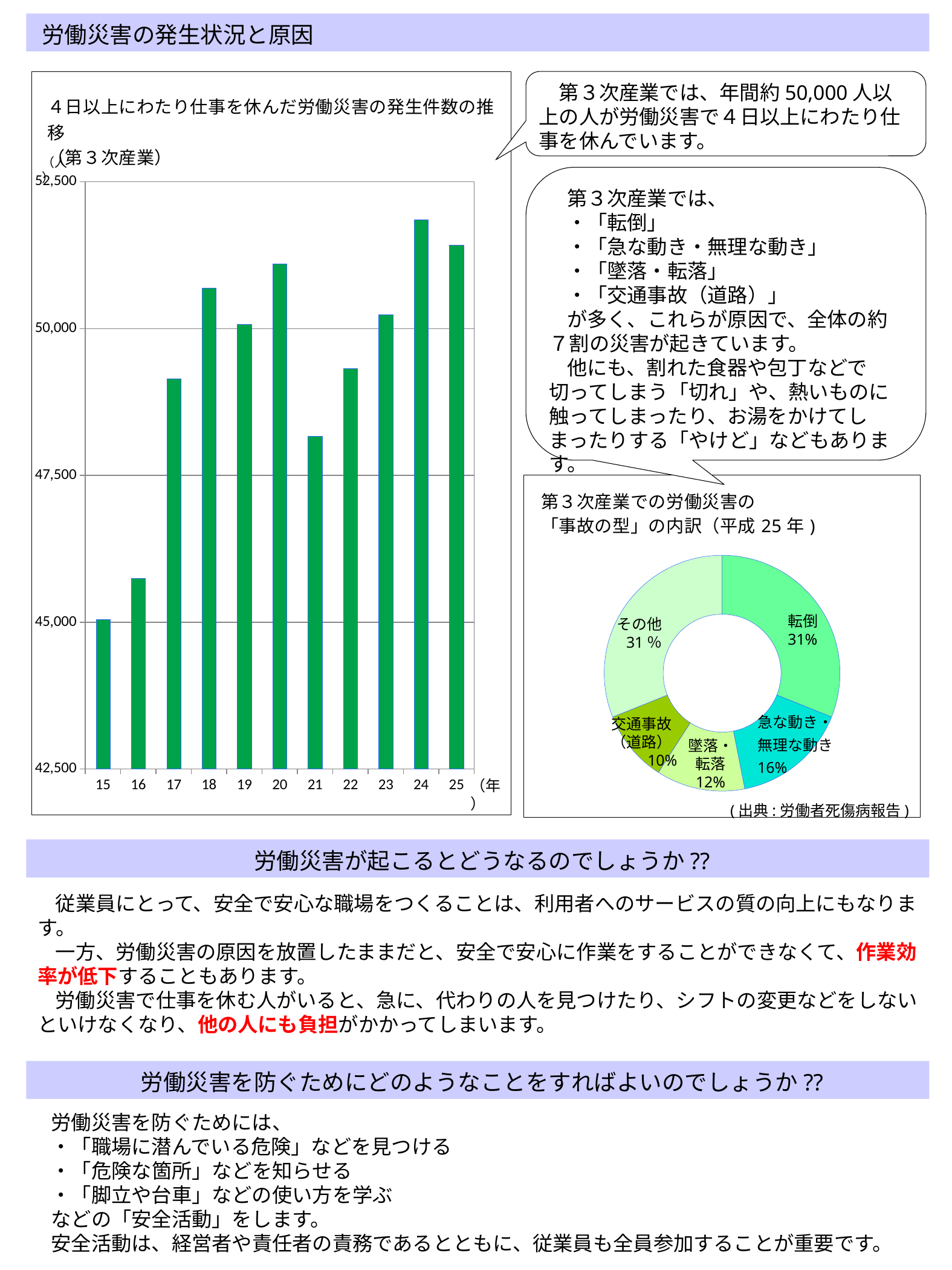
In the bar chart on the left, which year has the highest value? 24 In the bar chart on the left, how many years are plotted? 11 In the bar chart on the left, is the value for year 24 greater or less than 50,000? greater In the doughnut chart on the right, which category has the smallest share? 交通事故（道路） In the bar chart on the left, is the value for year 21 greater or less than 47,500? greater In the bar chart on the left, which year has the lowest value? 15 In the doughnut chart on the right, what share is 転倒? 31% In the doughnut chart on the right, what is the difference between the shares of 転倒 and 急な動き・無理な動き? 15 percentage points What kind of chart is the chart on the left? bar chart In the bar chart on the left, is the value for year 17 greater or less than 50,000? less In the bar chart on the left, do the values rise or fall from year 15 to year 18? rise In the doughnut chart on the right, how many categories are shown? 5